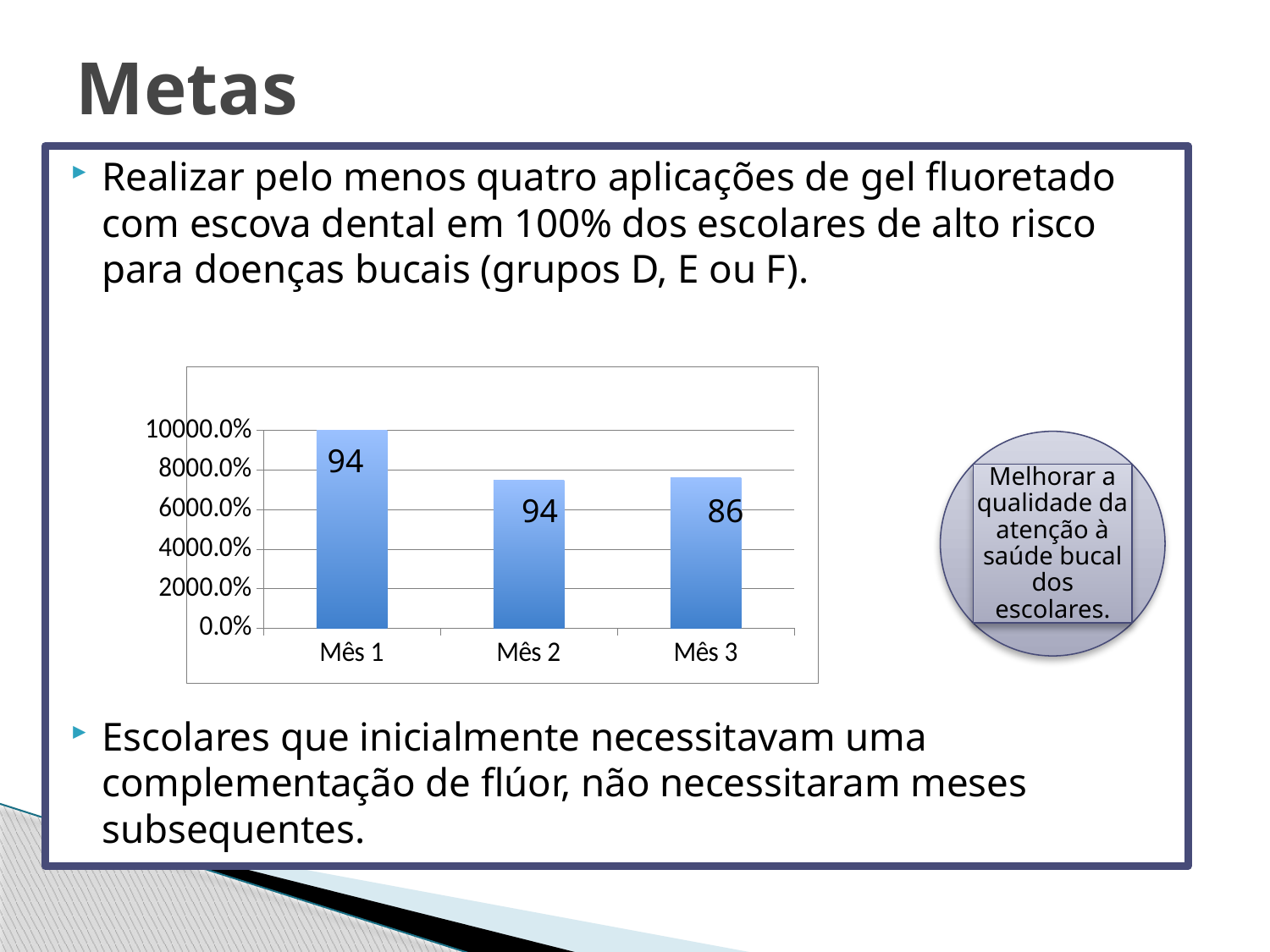
Is the bar for Mês 3 greater or less than 6000.0% on the y axis? greater How many categories are shown on the x axis of the chart? 3 What is the difference between the data labels for Mês 1 and Mês 3? 8 What is the data label on the bar for Mês 1? 94 What is the data label on the bar for Mês 3? 86 Which is larger, the value for Mês 1 or the value for Mês 3? Mês 1 Is the bar for Mês 1 greater or less than 8000.0% on the y axis? greater What is the highest tick value shown on the y axis of the chart? 10000.0% What are the category labels on the x axis of the chart? Mês 1, Mês 2, Mês 3 What kind of chart is shown on the slide? bar chart Is the bar for Mês 2 greater or less than 8000.0% on the y axis? less What is the data label on the bar for Mês 2? 94